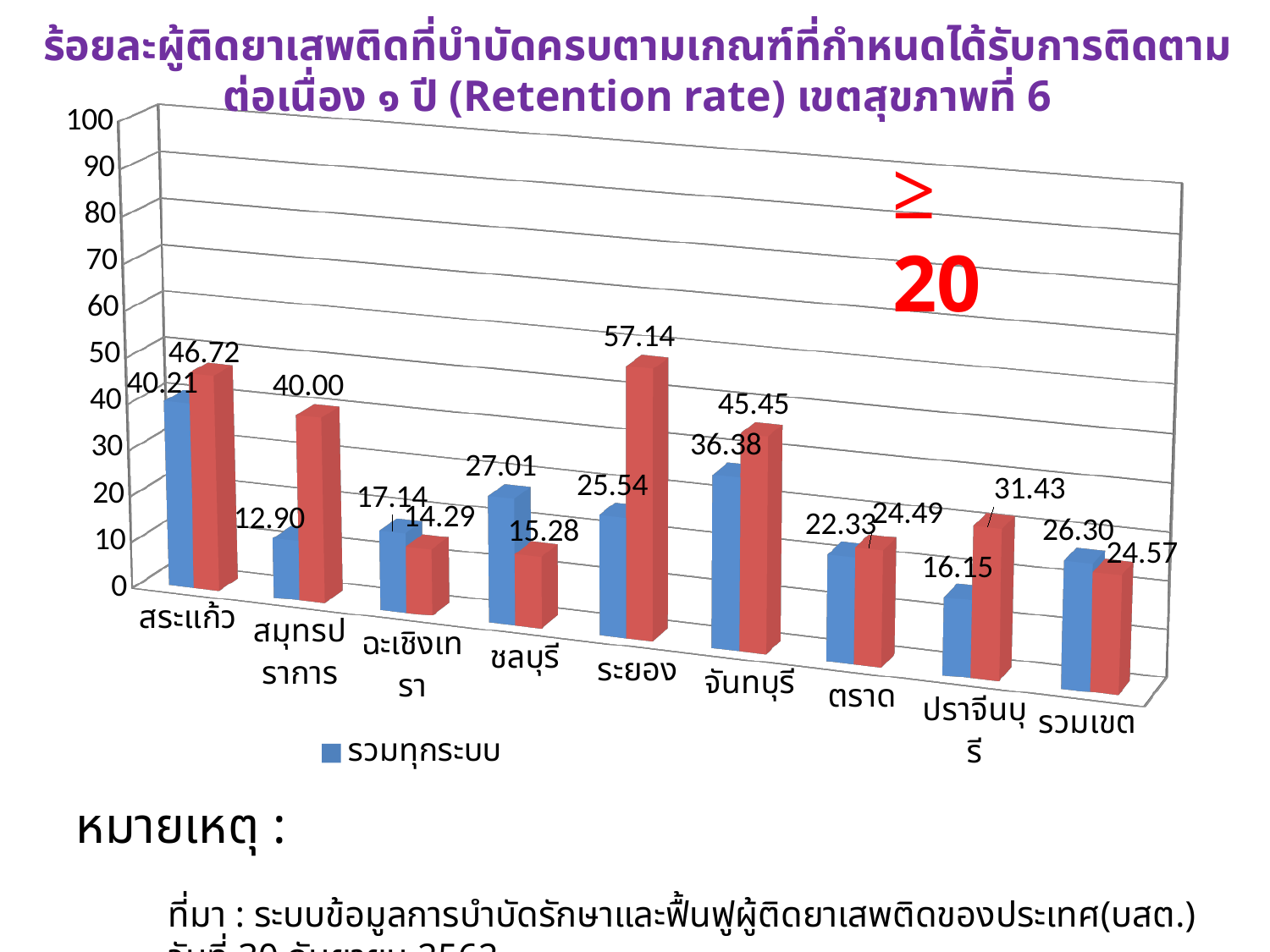
What is the value of the red bar for ปราจีนบุรี? 31.43 What is the value of the รวมทุกระบบ (blue) bar for รวมเขต? 26.30 What is the value of the รวมทุกระบบ (blue) bar for สระแก้ว? 40.21 What is the difference between the red bar and the blue bar for สมุทรปราการ? 27.10 Which category has the lowest รวมทุกระบบ (blue) bar? สมุทรปราการ Which category has the highest รวมทุกระบบ (blue) bar? สระแก้ว How many categories are shown on the x axis? 9 Is the red bar for จันทบุรี greater or less than 40? greater For ชลบุรี, which is larger: the blue bar or the red bar? the blue bar What is the value of the red bar for ระยอง? 57.14 What type of chart is shown on the slide? bar chart Which category has the highest red bar? ระยอง